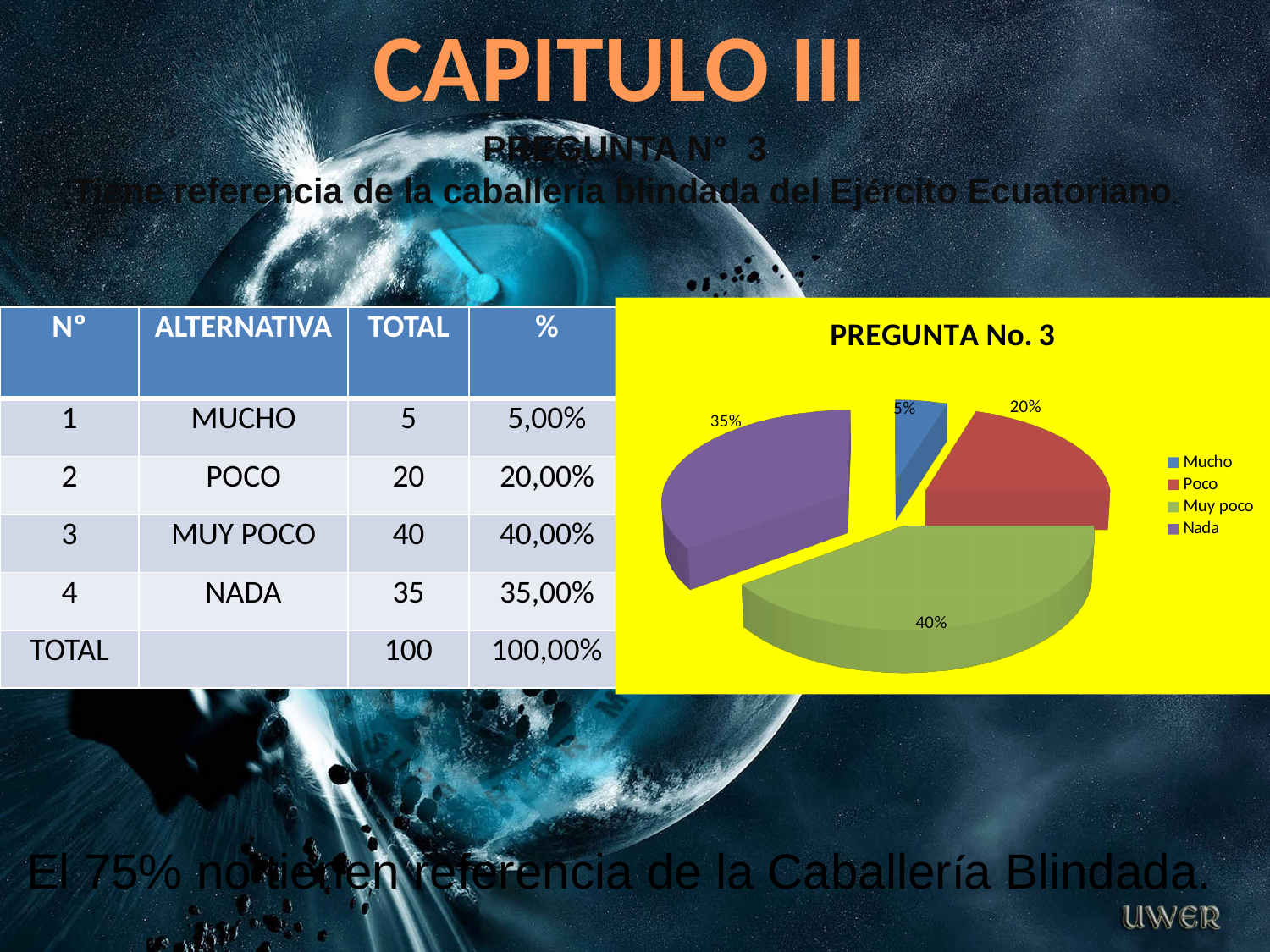
How many slices does the pie chart have? 4 What percentage does the Nada slice show? 35% What is the difference in percentage points between the Muy poco slice and the Poco slice? 20 What type of chart is shown on the slide? pie chart What percentage does the Muy poco slice show? 40% Which category has the smallest slice of the pie? Mucho What percentage does the Mucho slice show? 5% How many entries does the legend list? 4 Which slice is larger, Nada or Poco? Nada What percentage does the Poco slice show? 20% What is the title of the chart? PREGUNTA No. 3 Which category has the largest slice of the pie? Muy poco